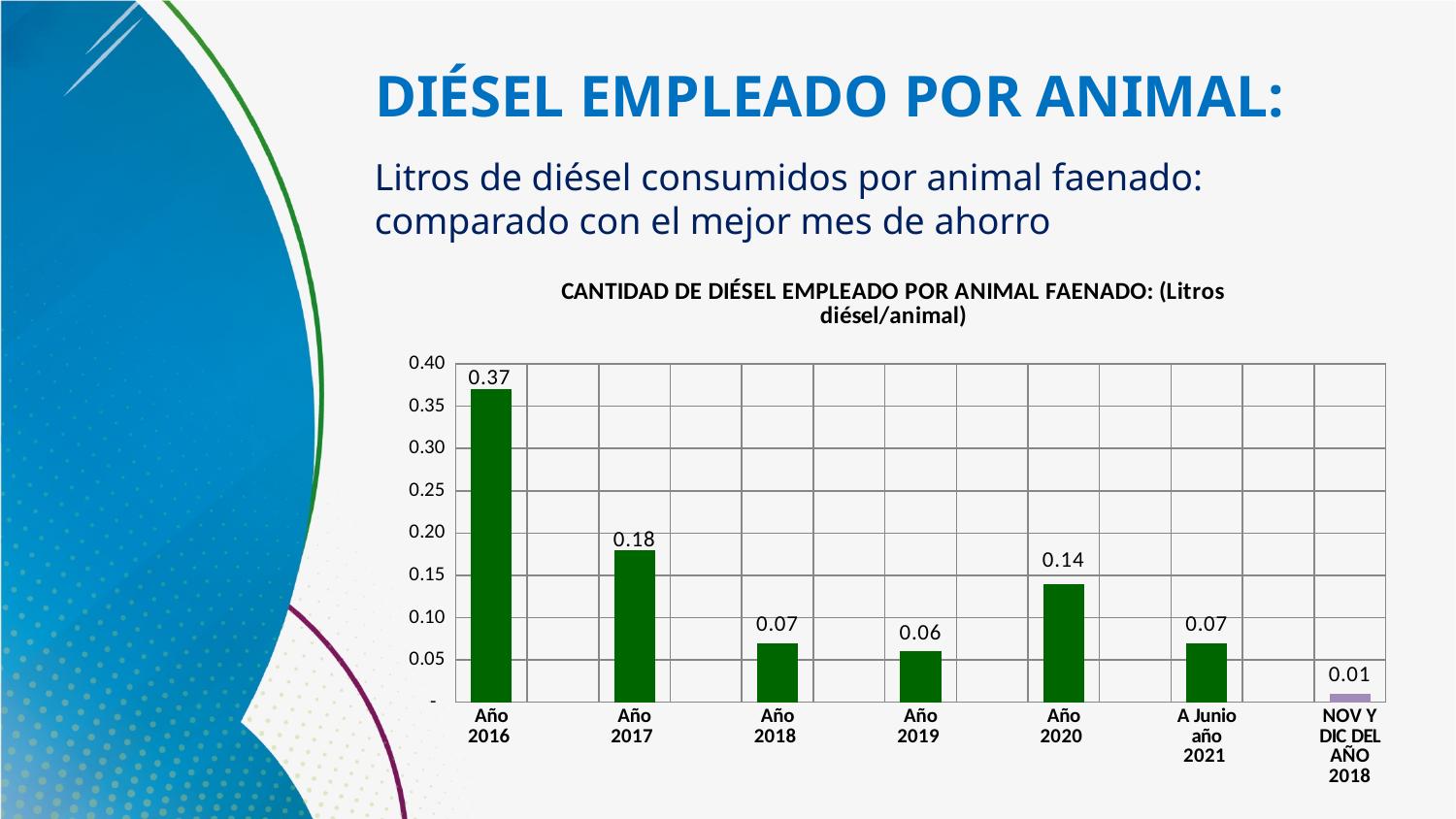
What is the difference between the values for Año 2016 and Año 2017? 0.19 What is the value for Año 2020? 0.14 Do the values rise or fall from Año 2016 to Año 2019? Fall Which category has the lowest value? NOV Y DIC DEL AÑO 2018 How many categories are shown on the x axis? 7 What is the title of the chart? CANTIDAD DE DIÉSEL EMPLEADO POR ANIMAL FAENADO: (Litros diésel/animal) Which category has the highest value? Año 2016 Is the value for Año 2017 greater or less than 0.15? greater What is the value for NOV Y DIC DEL AÑO 2018? 0.01 Which is larger, the value for Año 2019 or the value for Año 2020? Año 2020 What kind of chart is this? Bar chart What is the value for Año 2016? 0.37